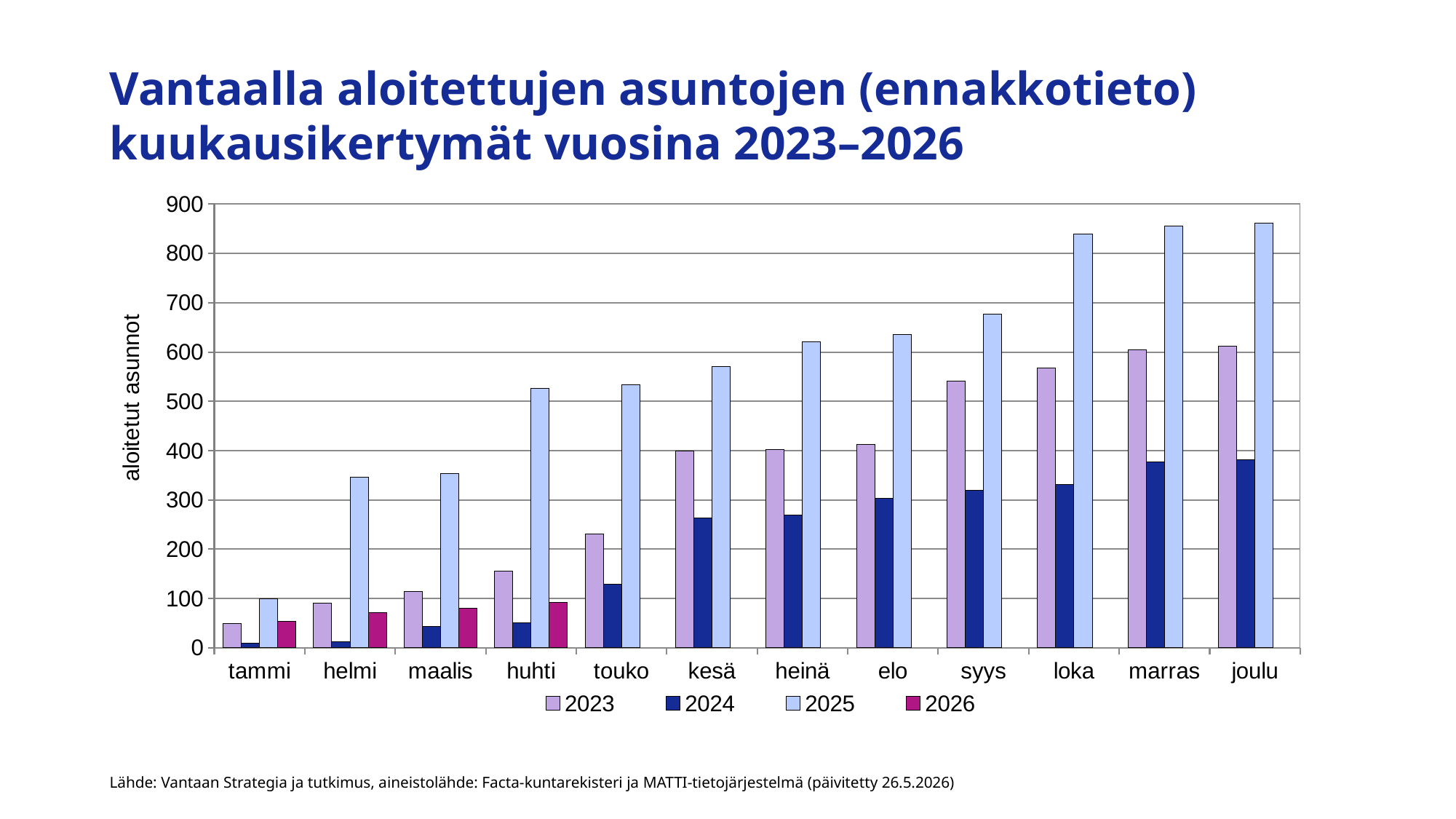
Is the value for 2024 in tammi greater or less than 100? less In kesä, which is larger: the value for 2023 or the value for 2024? 2023 How many series does the legend list? 4 Which series has the highest value in joulu? 2025 Do the values for the 2025 series rise or fall from tammi to joulu? rise Is the value for 2025 in huhti greater or less than 500? greater Which month has the lowest value for the 2025 series? tammi How many months are shown on the x axis? 12 Is the value for 2025 in joulu greater or less than 800? greater For how many months is a 2026 bar plotted? 4 What kind of chart is shown on the slide? bar chart